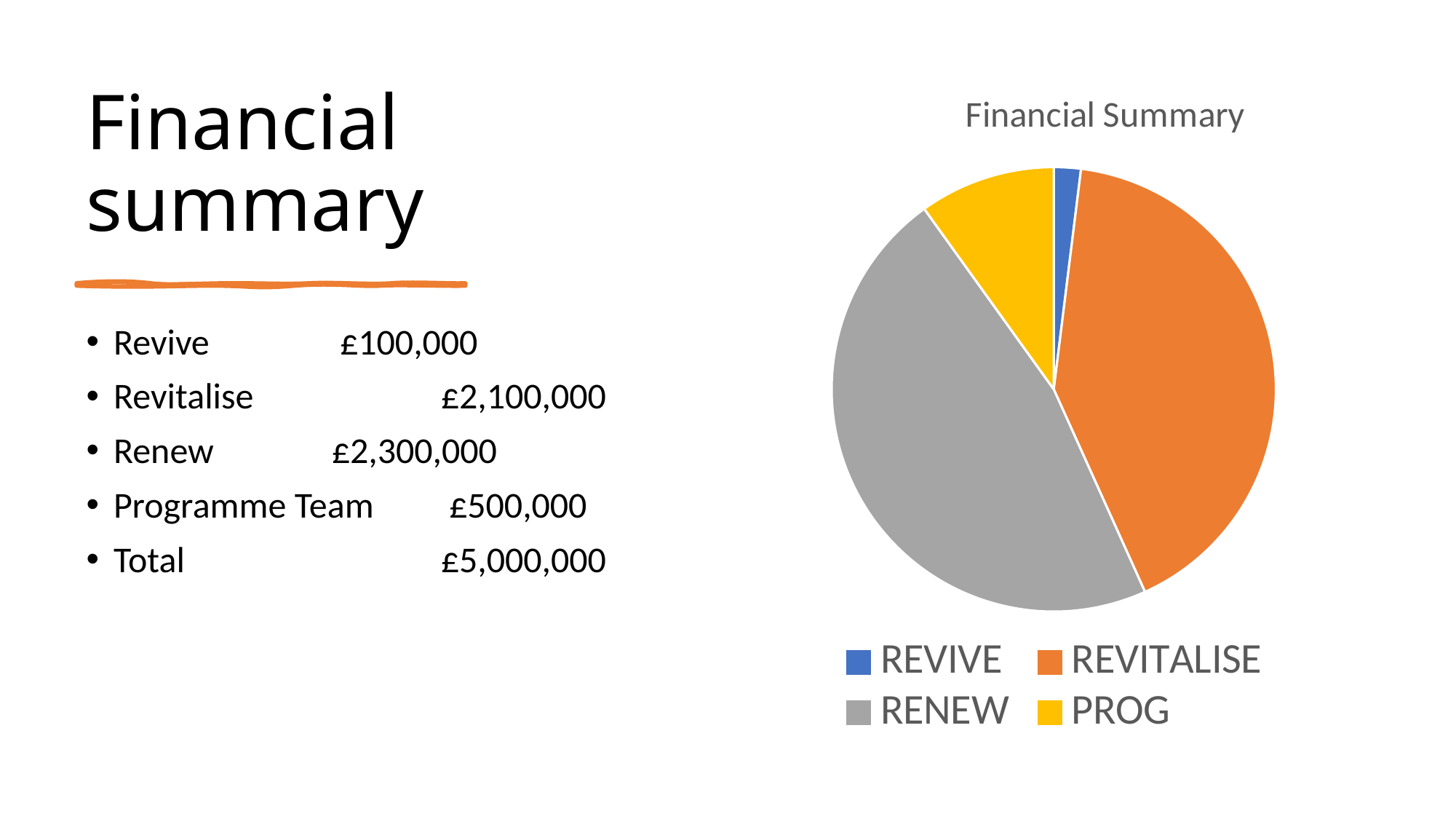
What value does the slide give for Revitalise? £2,100,000 How many entries does the chart legend list? 4 What value does the slide give for Renew? £2,300,000 Which slice of the pie chart is the largest? RENEW What is the title of the chart? Financial Summary What colour is the REVIVE slice in the pie chart? blue Which is larger, the REVITALISE slice or the PROG slice? REVITALISE What share of the total does the PROG (Programme Team) slice represent? 10% What is the difference between the Renew and Revitalise values? £200,000 How many slices does the pie chart have? 4 What kind of chart is shown on the slide? pie chart Which slice of the pie chart is the smallest? REVIVE